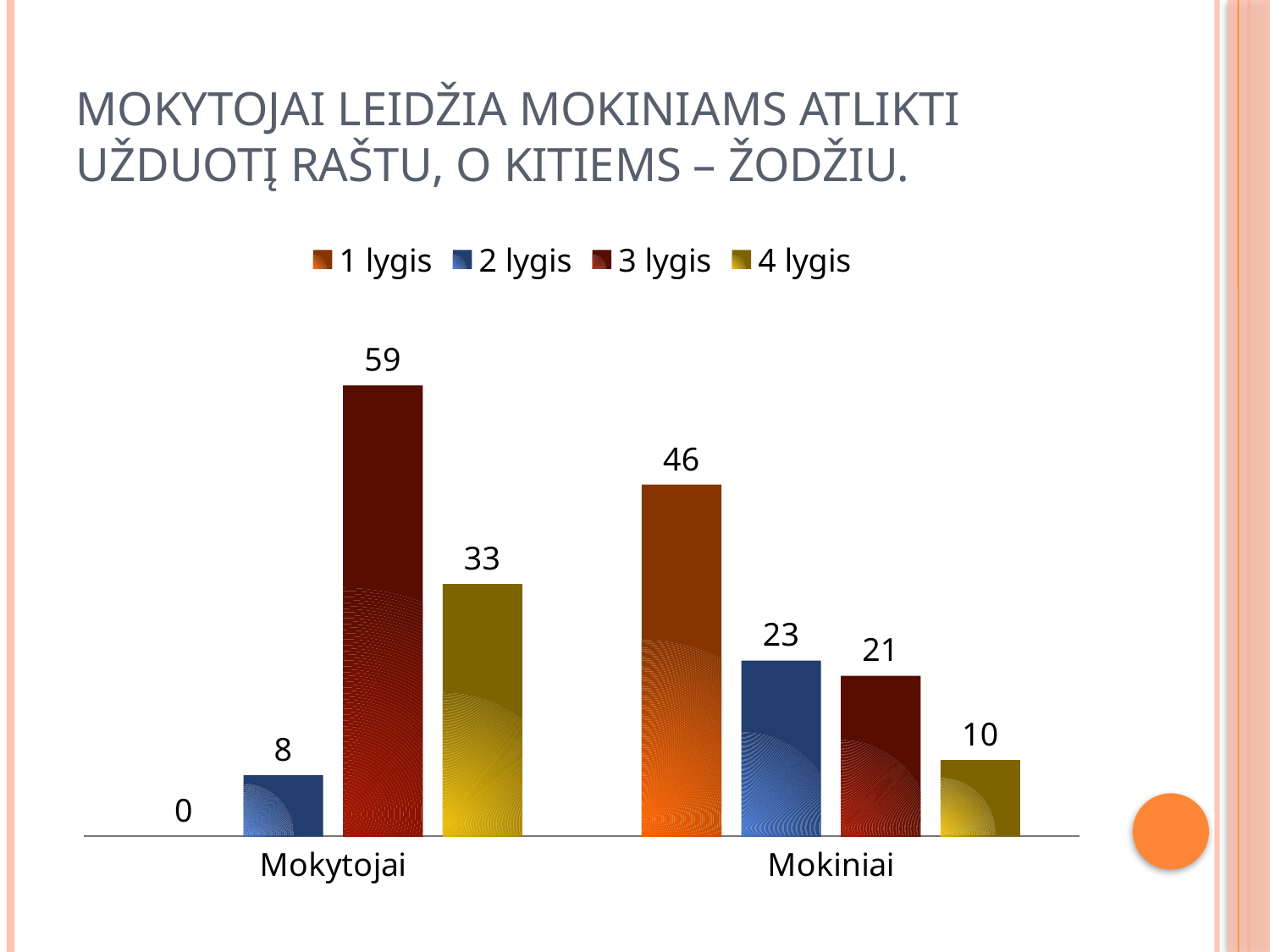
What is the value for 1 lygis in the Mokytojai category? 0 How many categories are shown on the x axis? 2 What is the value for 1 lygis in the Mokiniai category? 46 What is the value for 4 lygis in the Mokytojai category? 33 What is the difference between the 3 lygis values for Mokytojai and Mokiniai? 38 What is the value for 2 lygis in the Mokiniai category? 23 Which series has the highest value in the Mokiniai category? 1 lygis Which series has the lowest value in the Mokytojai category? 1 lygis Which is larger: the 4 lygis value for Mokytojai or for Mokiniai? Mokytojai How many series does the legend list? 4 What is the value for 3 lygis in the Mokytojai category? 59 What kind of chart is shown on the slide? Bar chart